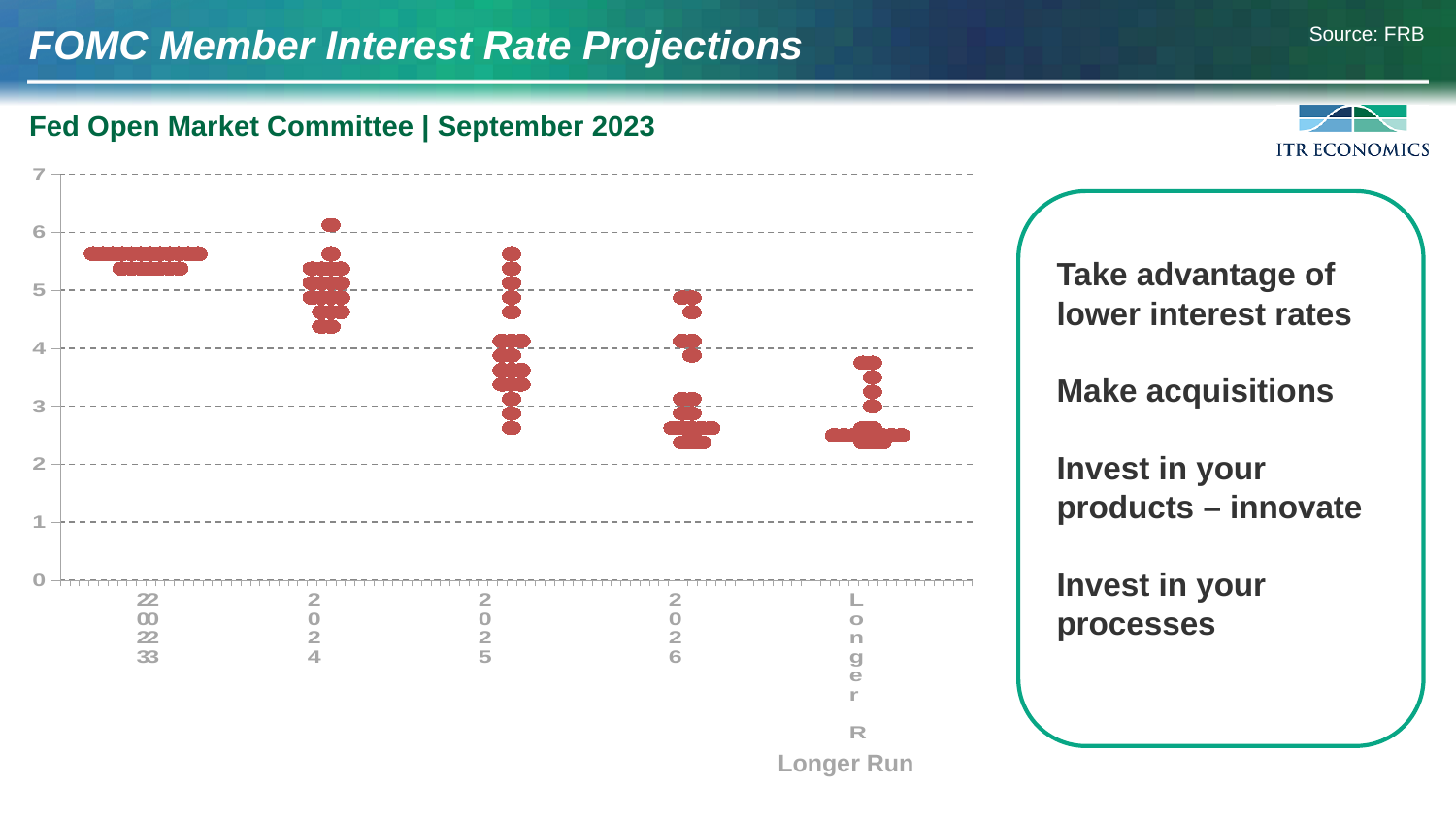
How many categories are shown along the x axis of the chart? 5 What is the last category on the x axis of the chart? Longer Run Which has higher projected interest rates, 2023 or 2026? 2023 Are the projections for 2024 greater or less than 4? greater Do the projected interest rates generally rise or fall from 2023 to Longer Run? fall Which has higher projected interest rates, 2023 or Longer Run? 2023 What is the subtitle shown above the chart? Fed Open Market Committee | September 2023 Are the projections for Longer Run greater or less than 2? greater Are the projections for 2026 greater or less than 6? less What kind of chart is shown on the slide? dot plot (scatter chart)